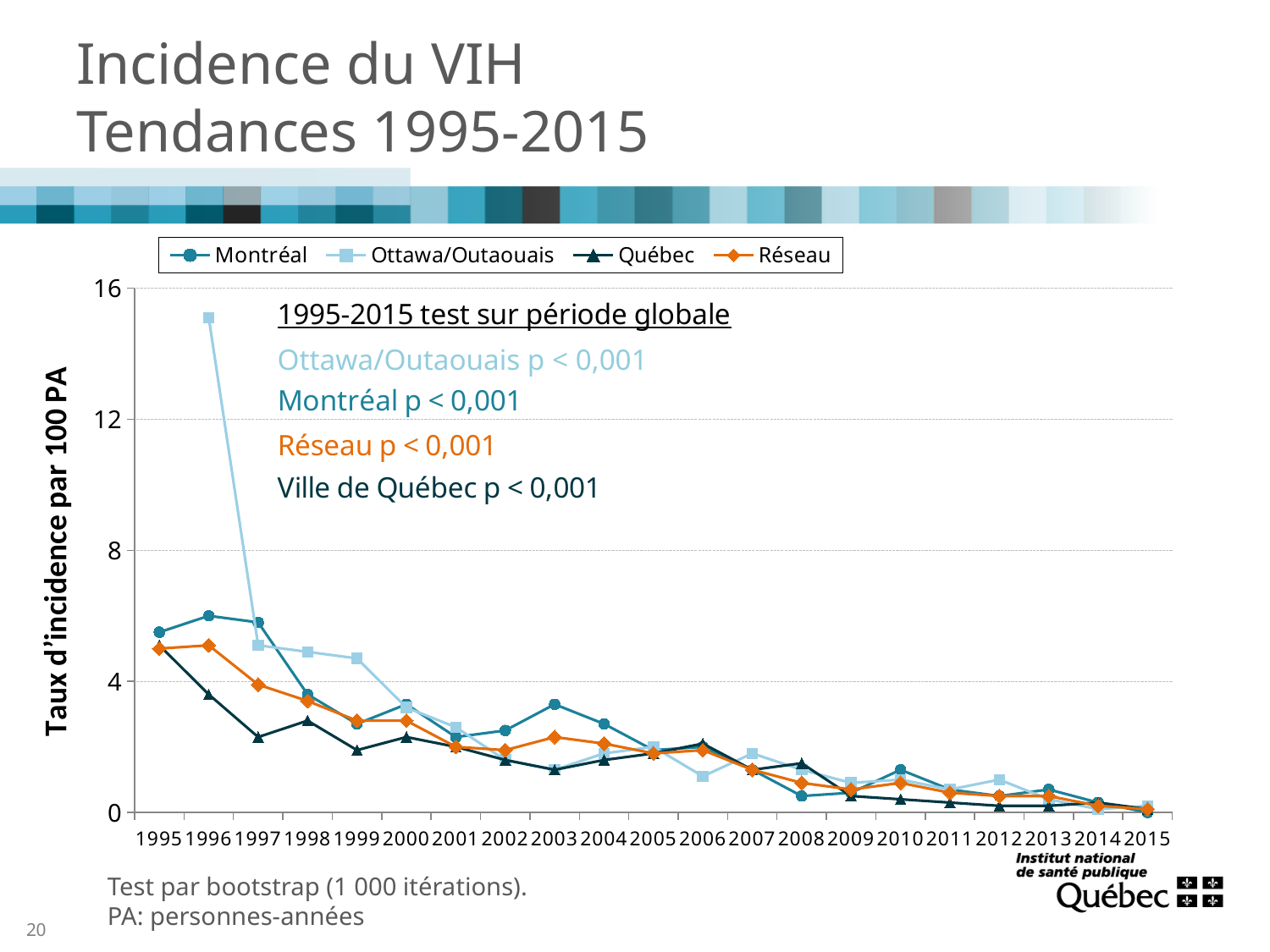
How many years are plotted along the x axis? 21 Do the values for Réseau generally rise or fall from 1995 to 2015? fall What is the label of the y axis? Taux d'incidence par 100 PA In which year does the Ottawa/Outaouais series reach its highest value? 1996 What kind of chart is shown on the slide? line chart In 1997, which is larger, the value for Montréal or the value for Québec? Montréal Which series has the highest value in 1996? Ottawa/Outaouais Is the value for Réseau in 2015 greater or less than 4? less Is the value for Montréal in 1995 greater or less than 4? greater How many series does the legend list? 4 Is the value for Ottawa/Outaouais in 1996 greater or less than 12? greater